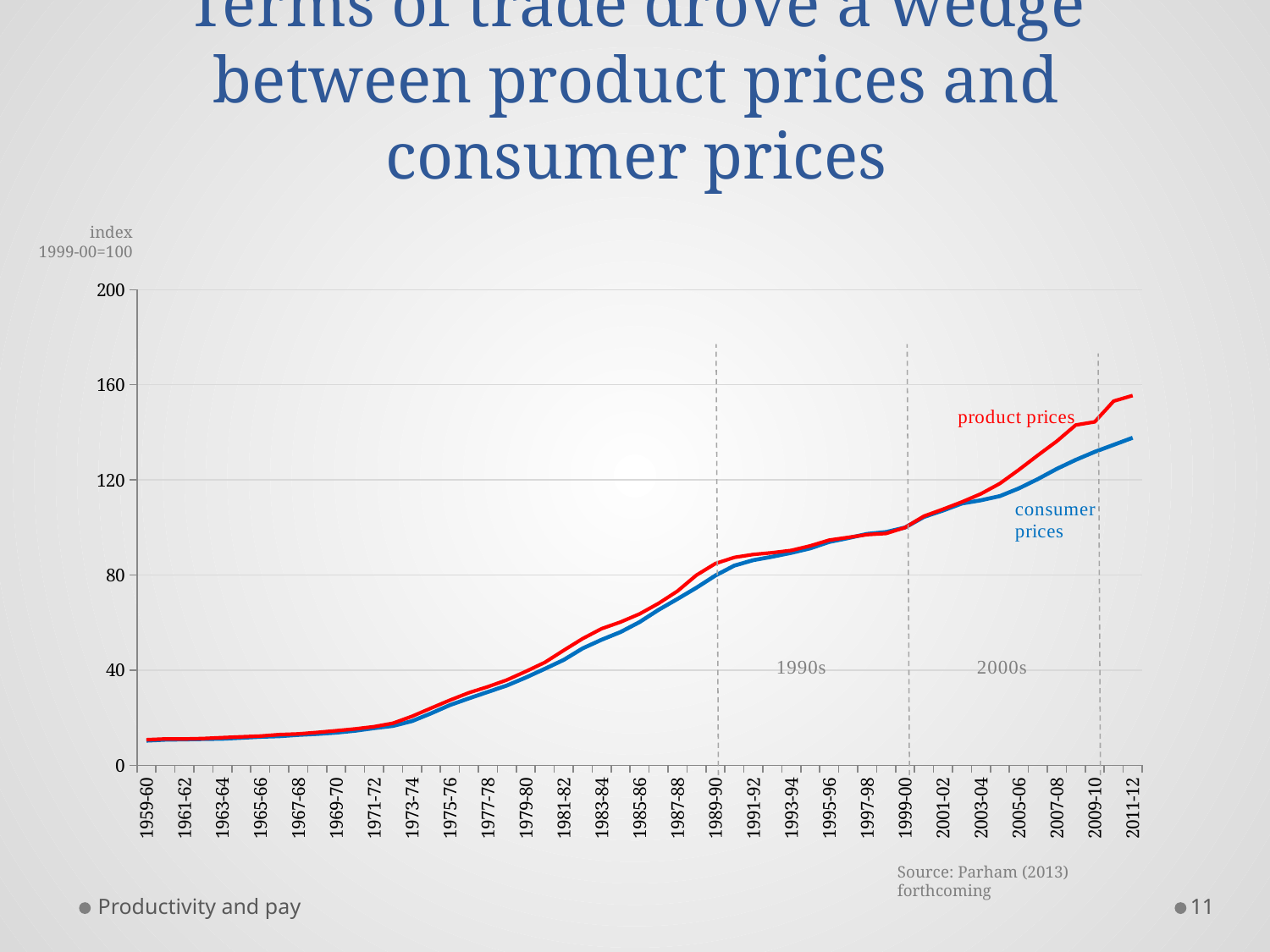
Which series reaches the highest value on the chart? product prices What is the last period label shown on the x axis? 2011-12 Is the value for consumer prices in 2011-12 greater or less than 160? less Do the values of the product prices series rise or fall over time along the x axis? rise What type of chart is shown on the slide? line chart What is the base period of the index used on the y axis? 1999-00=100 Is the value for product prices in 1959-60 greater or less than 40? less What are the names of the two series plotted on the chart? product prices and consumer prices How many series are plotted on the chart? 2 In 2011-12, which series has the higher value, product prices or consumer prices? product prices Is the value for product prices in 2007-08 greater or less than 120? greater